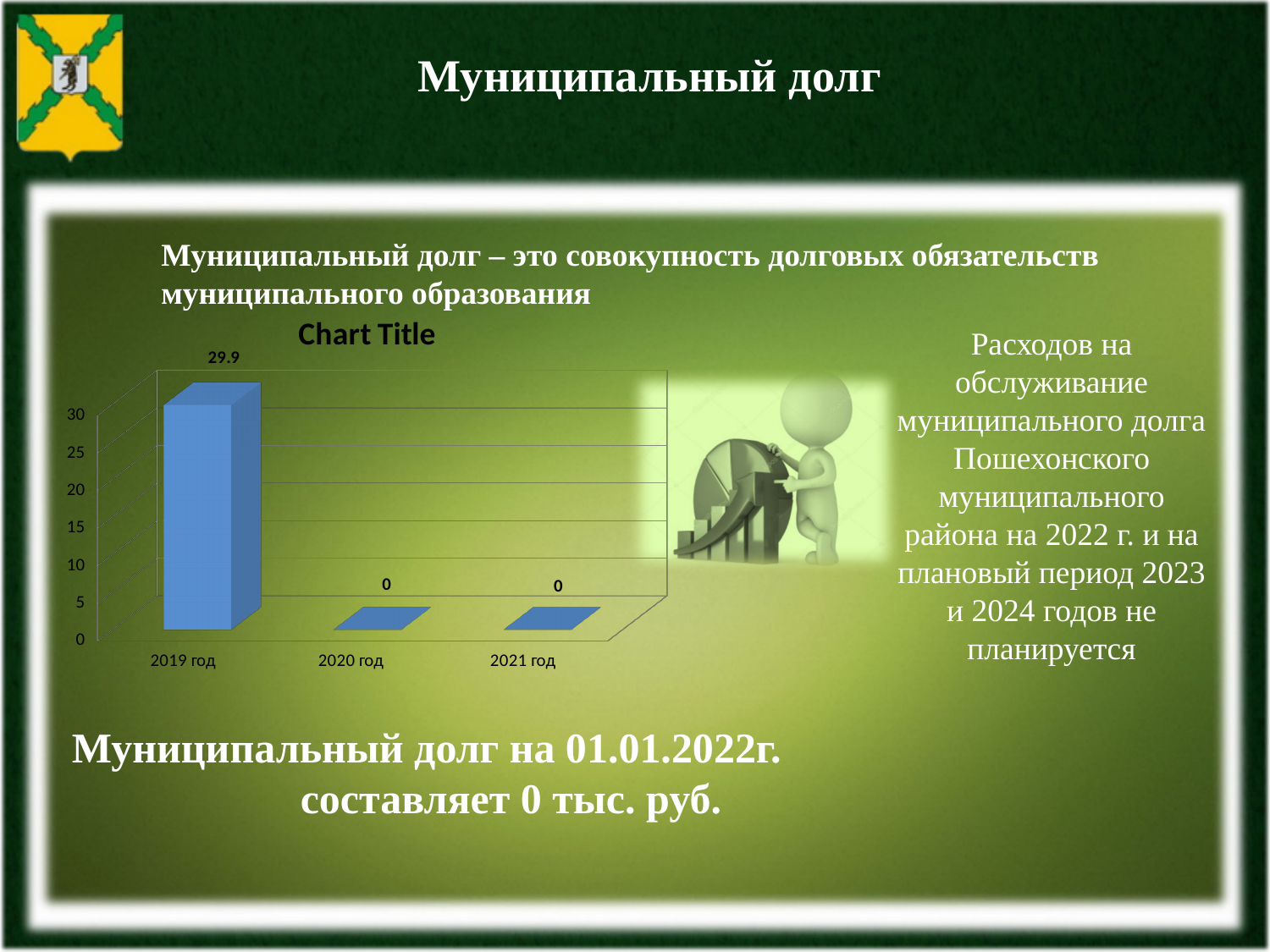
What kind of chart is shown on the slide? bar chart Which category has the highest value? 2019 год How many categories are shown on the x axis? 3 What is the value for 2020 год? 0 Which is larger, the value for 2019 год or the value for 2021 год? 2019 год What is the value for 2021 год? 0 Is the value for 2019 год greater or less than 25? greater What is the difference between the values for 2019 год and 2020 год? 29.9 What is the value for 2019 год? 29.9 Do the values rise or fall from 2019 год to 2021 год? fall What is the highest tick value shown on the vertical axis? 30 What is the title of the chart? Chart Title